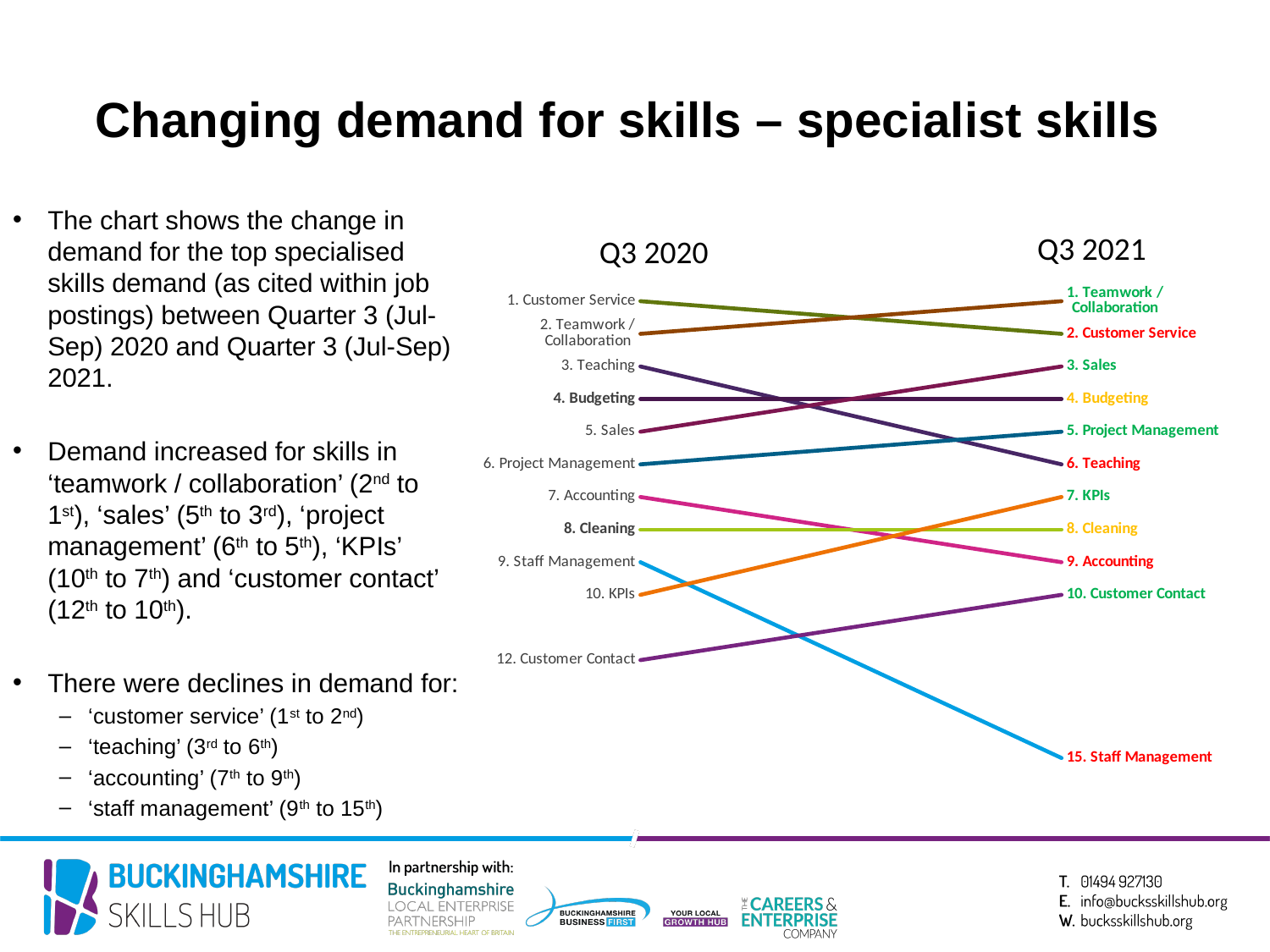
What rank did Teamwork / Collaboration hold in Q3 2021? 1 What rank did Customer Contact hold in Q3 2020? 12 By how many places did Staff Management's rank change between Q3 2020 and Q3 2021? 6 What rank did Staff Management hold in Q3 2021? 15 Which skill has the lowest (worst) rank in Q3 2021? Staff Management How many skills are plotted in the chart? 11 Which skill kept the same rank (4th) in both Q3 2020 and Q3 2021? Budgeting What rank did Customer Service hold in Q3 2020? 1 Which skill was ranked 5th in Q3 2021? Project Management Did the rank of Sales improve or worsen from Q3 2020 to Q3 2021? improve Which skill was ranked 3rd in Q3 2020? Teaching What are the two time periods compared in the chart? Q3 2020 and Q3 2021